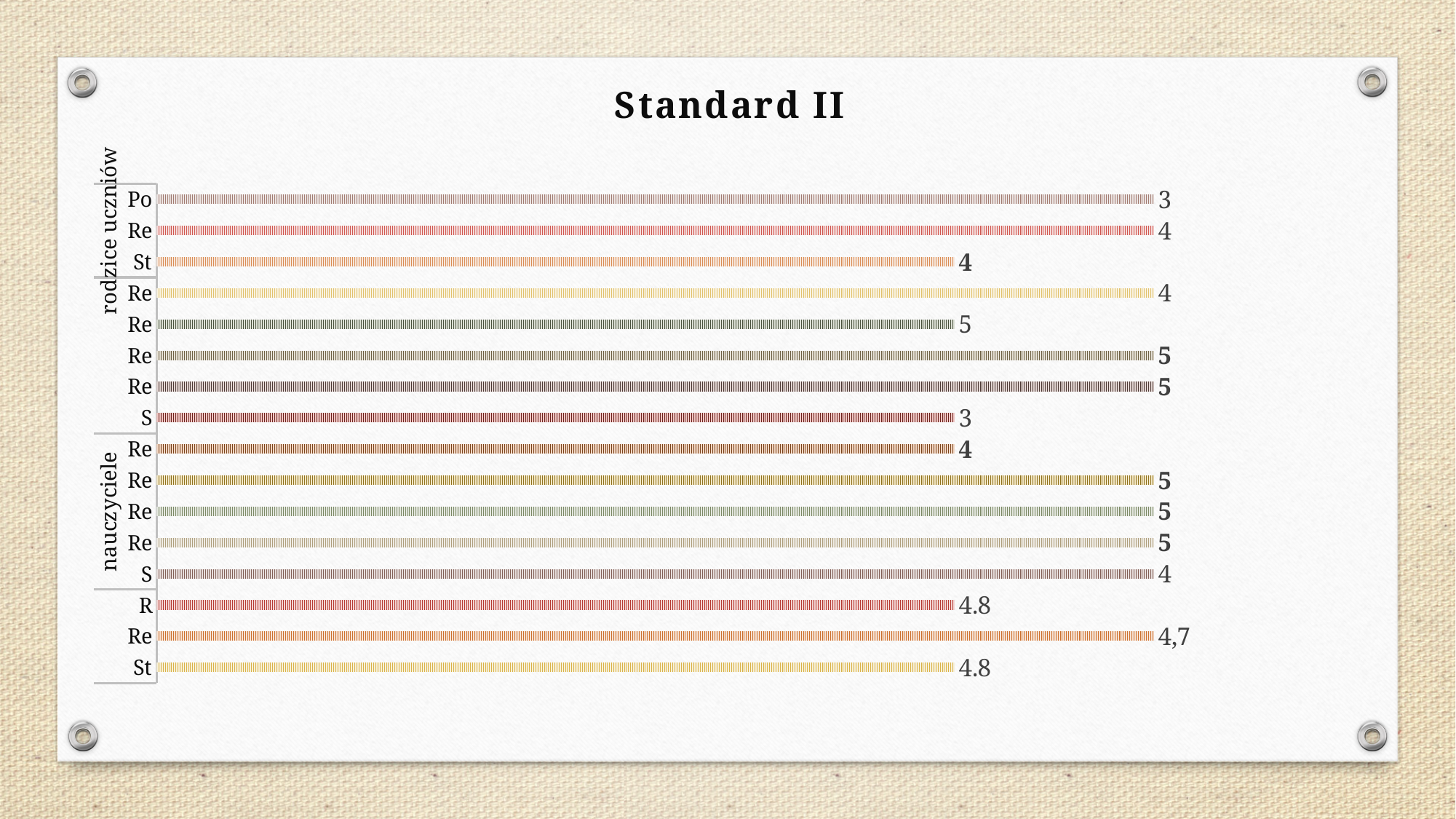
What is the value of the last bar in the nauczyciele group, labelled S? 4 Which is larger, the value for Po or the value for R? R What is the value of the bar labelled Re directly below the bar labelled R? 4,7 How many bars belong to the rodzice uczniów group? 3 What is the difference between the value for R and the value for Po? 1.8 How many bars does the chart contain? 16 What is the value of the bottom bar, labelled St? 4.8 What is the value of the bar labelled Po at the top of the chart? 3 What are the two group labels shown along the vertical axis? rodzice uczniów and nauczyciele What kind of chart is shown on the slide? bar chart What is the title of the chart? Standard II What is the value of the bar labelled R? 4.8